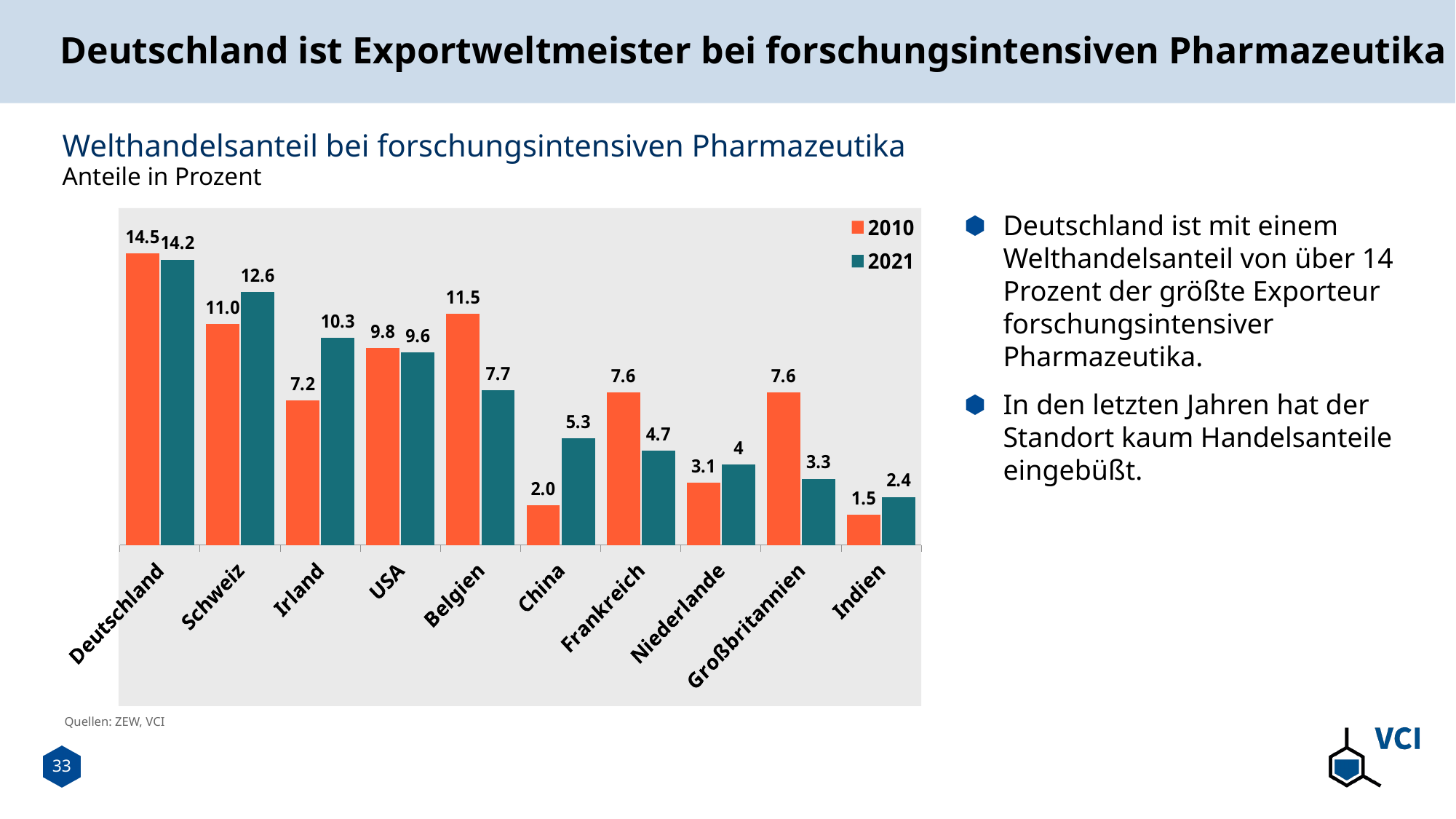
How many countries are shown on the x axis? 10 Which country has the highest value in 2021? Deutschland How many series does the legend list? 2 What is the difference between the 2010 and 2021 values for Schweiz? 1.6 What is the value for Belgien in 2010? 11.5 What is the difference between the 2010 and 2021 values for Belgien? 3.8 What is the value for Niederlande in 2021? 4 Which country has the lowest value in 2010? Indien What is the value for Deutschland in 2021? 14.2 What kind of chart is shown on the slide? Bar chart Which is larger for Großbritannien: the 2010 value or the 2021 value? 2010 Which is larger for Irland: the 2010 value or the 2021 value? 2021